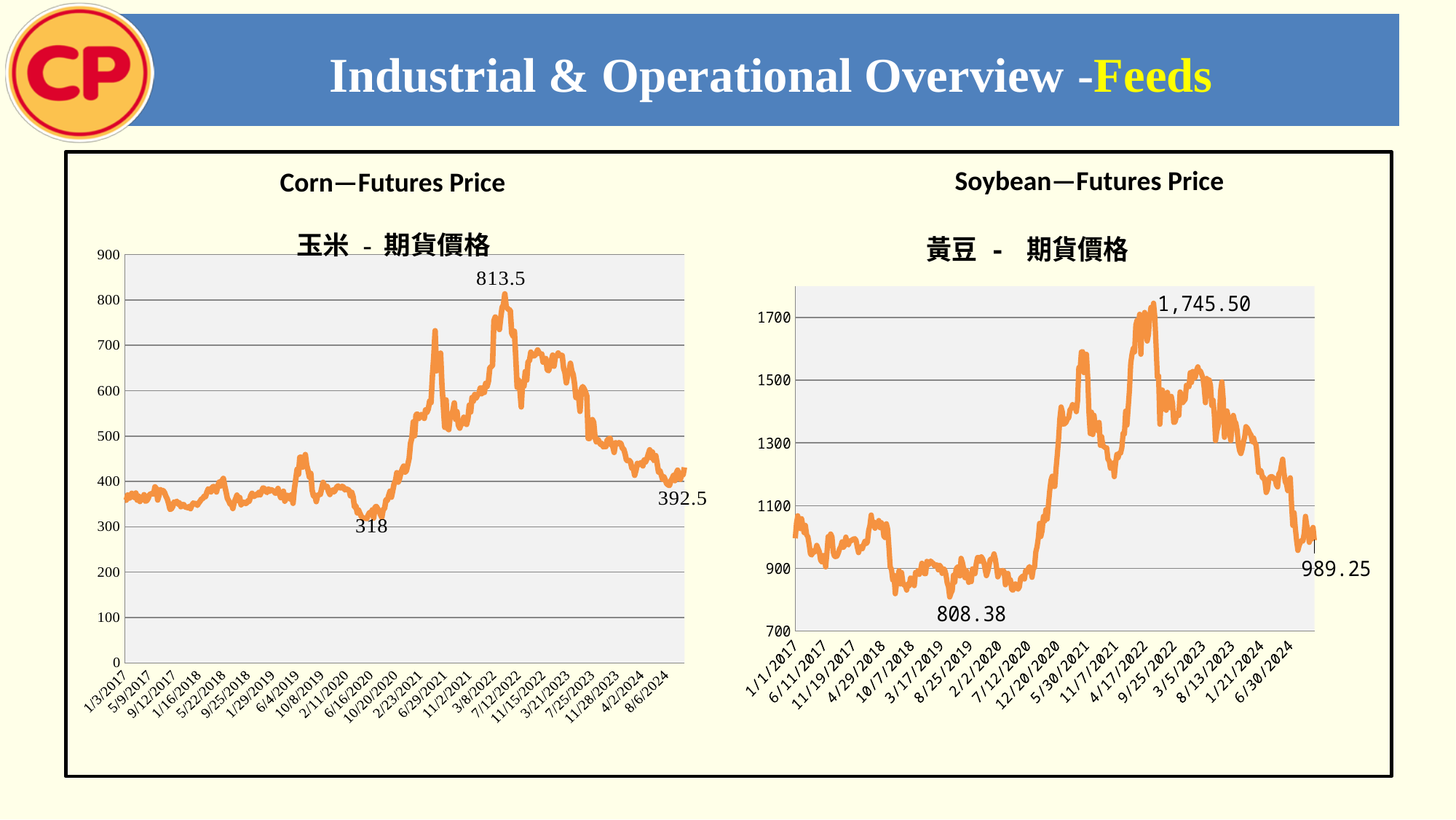
On the Corn—Futures Price chart, does the price rise or fall from its peak in 2022 to the end of the series? Fall On the Soybean—Futures Price chart, what is the highest labelled value? 1,745.50 Which chart has the higher peak value, Corn—Futures Price or Soybean—Futures Price? Soybean—Futures Price On the Soybean—Futures Price chart, is the value at 1/1/2017 greater or less than 1100? less On the Soybean—Futures Price chart, what is the lowest labelled value? 808.38 On the Corn—Futures Price chart, what is the lowest labelled value? 318 On the Corn—Futures Price chart, what is the difference between the peak value and the final labelled value? 421 On the Corn—Futures Price chart, what is the value labelled at the end of the series? 392.5 What kind of chart is the Corn—Futures Price chart? Line chart On the Corn—Futures Price chart, what is the highest labelled value? 813.5 On the Soybean—Futures Price chart, what is the value labelled at the end of the series? 989.25 On the Soybean—Futures Price chart, what is the difference between the peak value and the final labelled value? 756.25